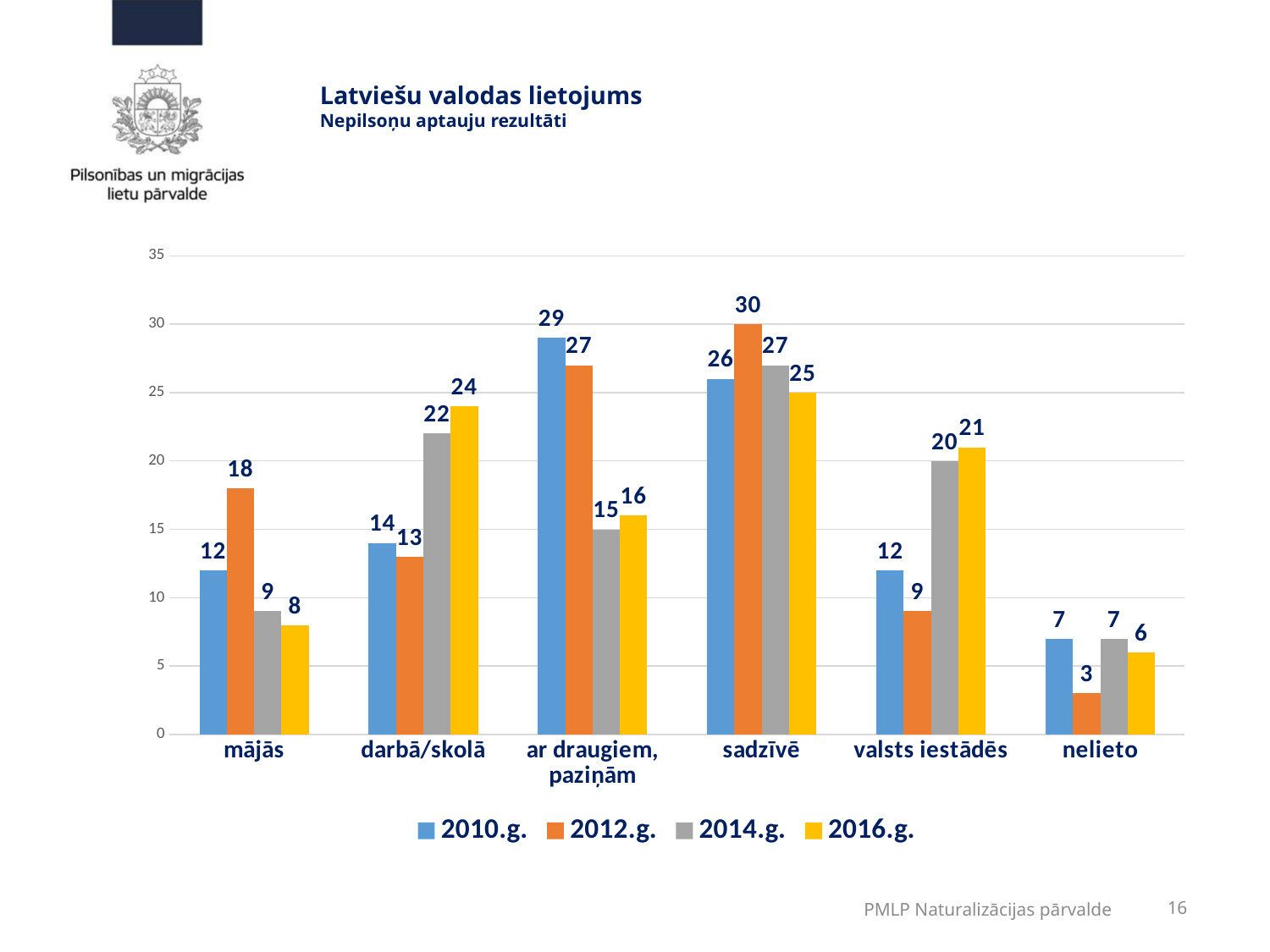
Do the values for the mājās category rise or fall from 2010.g. to 2016.g.? fall Which category has the highest value for 2012.g.? sadzīvē How many series does the legend list? 4 What is the value for 2012.g. in the mājās category? 18 What is the value for 2014.g. in the valsts iestādēs category? 20 Which category has the lowest value for 2010.g.? nelieto How many categories are shown on the x axis? 6 What is the difference between the 2010.g. and 2016.g. values in the ar draugiem, paziņām category? 13 Which is larger in the mājās category: the value for 2010.g. or the value for 2014.g.? 2010.g. What kind of chart is shown on the slide? bar chart What is the value for 2016.g. in the darbā/skolā category? 24 What is the title of the slide? Latviešu valodas lietojums